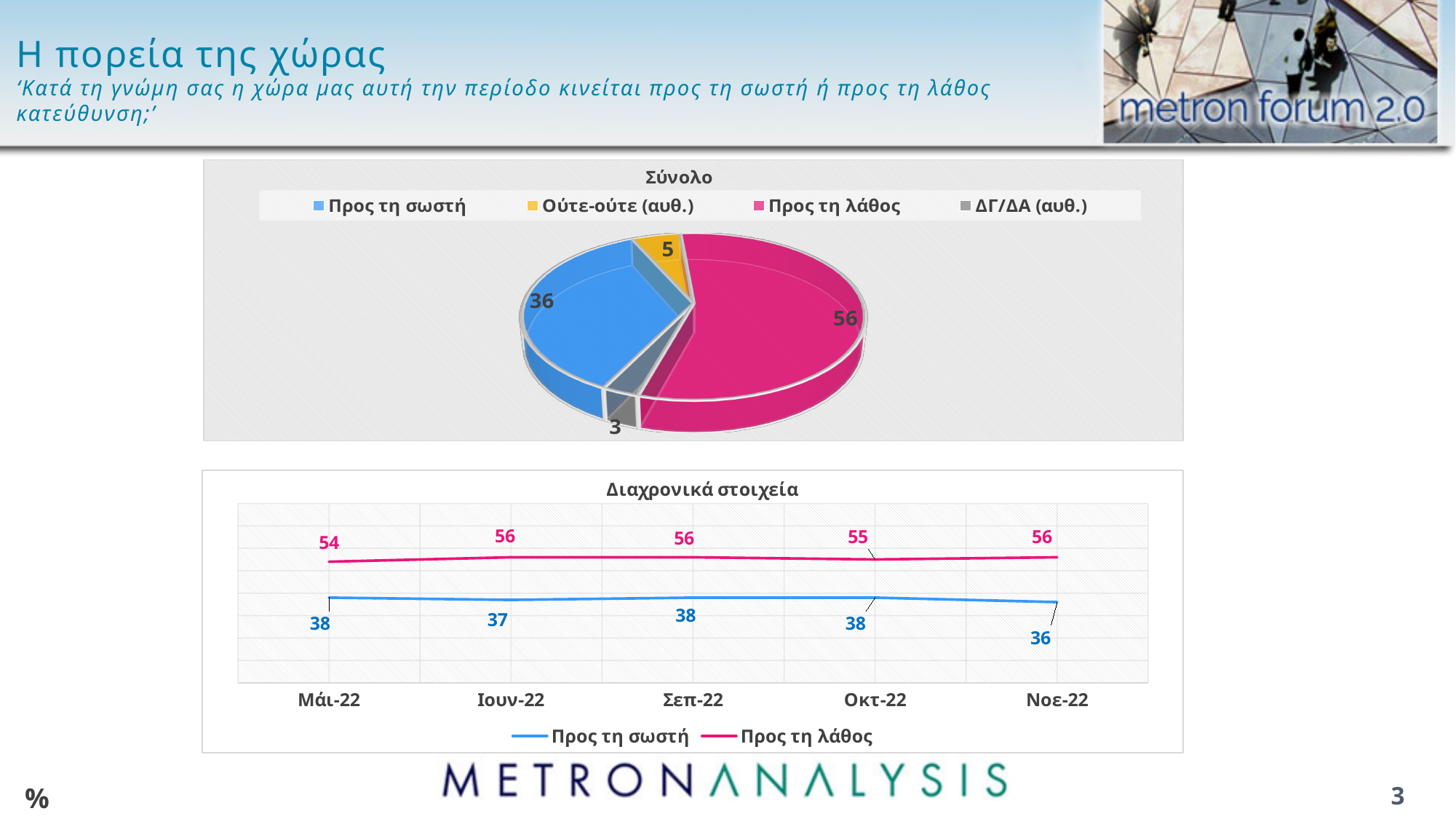
In the 'Σύνολο' pie chart, what is the value for 'Ούτε-ούτε (αυθ.)'? 5 In the 'Διαχρονικά στοιχεία' chart, how many time points are shown on the x axis? 5 In the 'Σύνολο' pie chart, which category has the smallest slice? ΔΓ/ΔΑ (αυθ.) In the 'Διαχρονικά στοιχεία' chart, what is the value for 'Προς τη σωστή' in Ιουν-22? 37 In the 'Διαχρονικά στοιχεία' chart, which is larger in Οκτ-22: 'Προς τη σωστή' or 'Προς τη λάθος'? Προς τη λάθος In the 'Διαχρονικά στοιχεία' chart, what is the value for 'Προς τη λάθος' in Μάι-22? 54 In the 'Σύνολο' pie chart, what is the value for 'Προς τη λάθος'? 56 In the 'Διαχρονικά στοιχεία' chart, how many series does the legend list? 2 In the 'Σύνολο' pie chart, what is the difference between 'Προς τη λάθος' and 'Προς τη σωστή'? 20 In the 'Σύνολο' pie chart, which category has the largest slice? Προς τη λάθος How many categories does the 'Σύνολο' pie chart show? 4 What type of chart is the 'Διαχρονικά στοιχεία' chart? Line chart